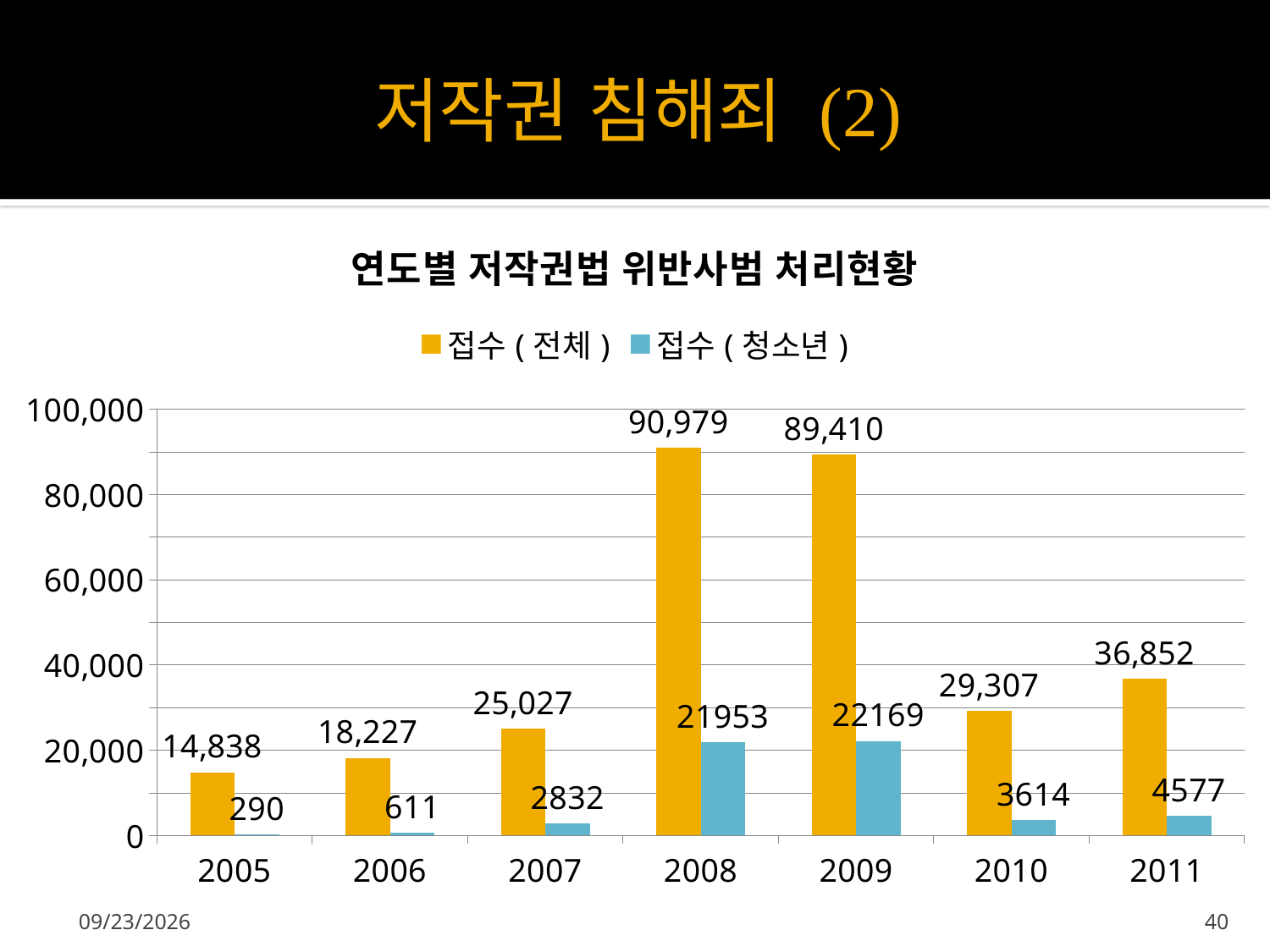
What is the value of 접수 ( 전체 ) for 2005? 14,838 What is the title of the chart? 연도별 저작권법 위반사범 처리현황 What is the difference between 접수 ( 전체 ) in 2008 and 2009? 1,569 What is the value of 접수 ( 전체 ) for 2008? 90,979 What kind of chart is shown on the slide? bar chart Is the value of 접수 ( 전체 ) for 2011 greater or less than 40,000? less How many years are shown on the x axis? 7 Which year has the lowest value for 접수 ( 청소년 )? 2005 Which is larger, 접수 ( 청소년 ) in 2009 or in 2008? 2009 Which year has the highest value for 접수 ( 전체 )? 2008 How many series does the legend list? 2 What is the value of 접수 ( 청소년 ) for 2011? 4577